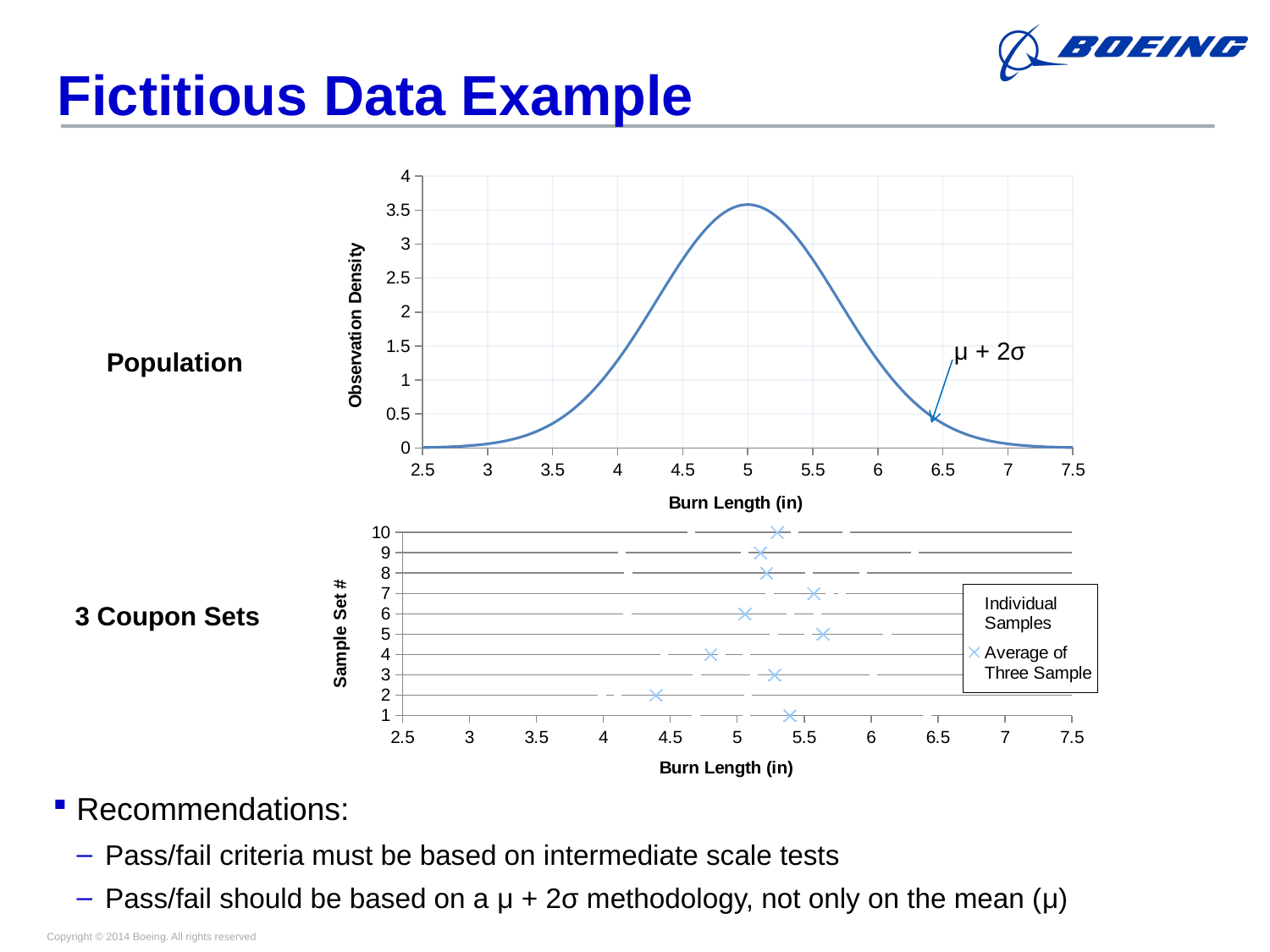
In the top "Population" chart, what is the label of the y axis? Observation Density In the bottom "3 Coupon Sets" chart, which sample set has the lowest average of three samples? 2 What kind of chart is the bottom chart labelled "3 Coupon Sets"? scatter chart What kind of chart is the top chart labelled "Population"? line chart In the bottom "3 Coupon Sets" chart, how many sample sets are shown on the y axis? 10 In the top "Population" chart, what annotation is pointed to by the arrow on the right side of the curve? μ + 2σ In the bottom "3 Coupon Sets" chart, how many series does the legend list? 2 In the top "Population" chart, is the observation density at a burn length of 6.5 greater or less than 1? less In the bottom "3 Coupon Sets" chart, is the average of three samples for sample set 2 greater or less than 5? less In the top "Population" chart, is the observation density at a burn length of 3.5 greater or less than 0.5? less In the bottom "3 Coupon Sets" chart, which has the larger average of three samples, sample set 4 or sample set 5? sample set 5